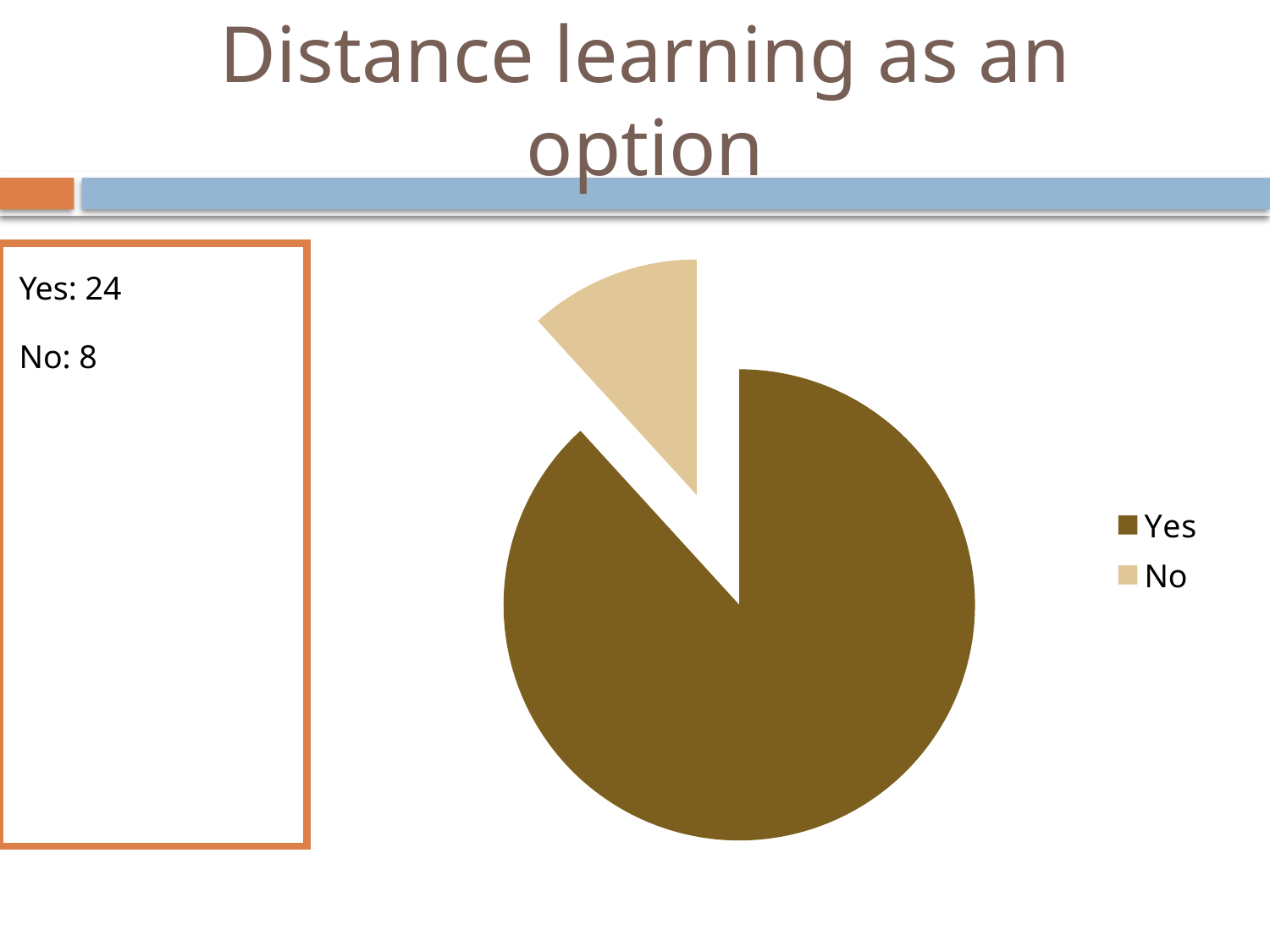
What is the value for No? 8 What is the value for Yes? 24 Which category has the smallest slice of the pie? No How many slices does the pie chart have? 2 What is the total of the values for Yes and No? 32 How many entries does the legend of the pie chart list? 2 What is the title of the slide containing the pie chart? Distance learning as an option What kind of chart is shown on the slide? pie chart Which is larger, the value for Yes or the value for No? Yes What is the difference between the value for Yes and the value for No? 16 Which category has the largest slice of the pie? Yes